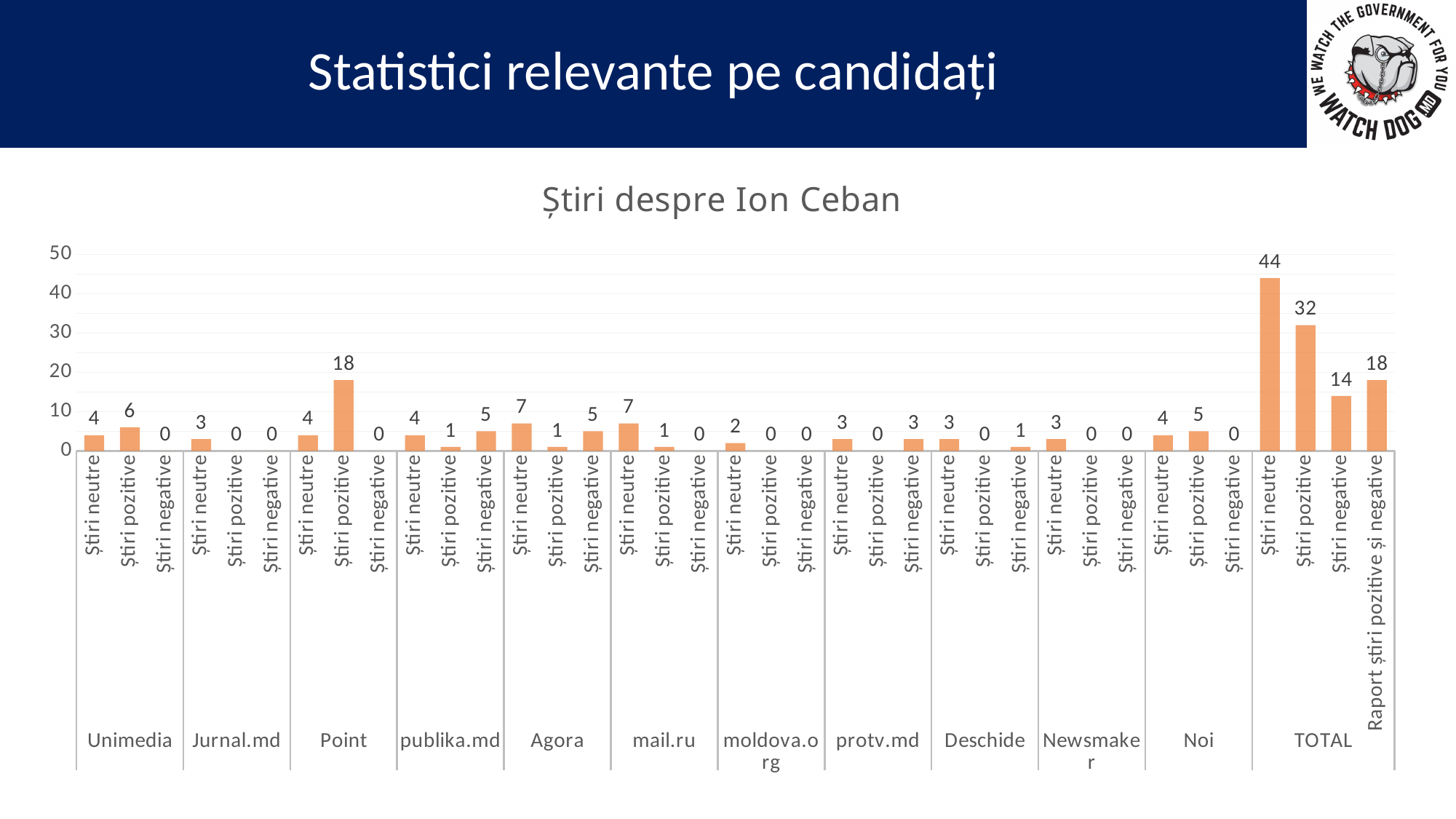
What is the value of Știri neutre in the TOTAL group? 44 How many media outlet groups, including TOTAL, are shown on the x axis? 12 What is the title of the chart? Știri despre Ion Ceban Which is larger: Știri pozitive for Unimedia or Știri pozitive for Noi? Unimedia Which bar in the chart has the highest value? Știri neutre (TOTAL) Is the value of Știri pozitive in the TOTAL group greater or less than 30? greater What kind of chart is shown on the slide? bar chart What is the value of Știri neutre for Agora? 7 What is the value of Știri negative for publika.md? 5 What is the value of Știri pozitive for Point? 18 What is the value of Raport știri pozitive și negative in the TOTAL group? 18 What is the difference between Știri neutre and Știri pozitive in the TOTAL group? 12